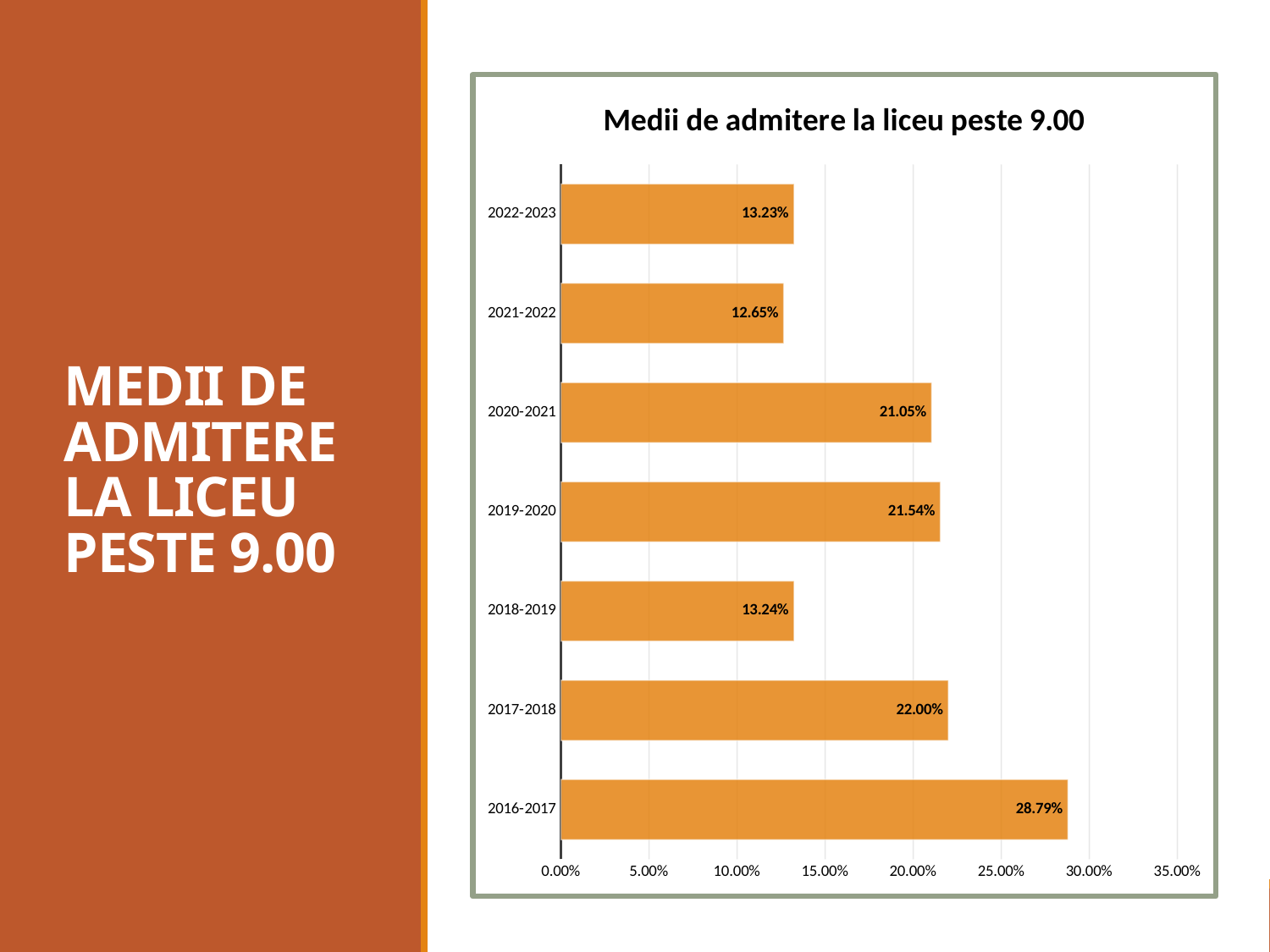
Which is larger, the value for 2017-2018 or the value for 2018-2019? 2017-2018 How many school years are shown in the chart? 7 Which school year has the highest value? 2016-2017 What is the value for 2016-2017? 28.79% What is the value for 2020-2021? 21.05% What is the value for 2022-2023? 13.23% What is the difference between the values for 2019-2020 and 2020-2021? 0.49% What is the difference between the values for 2016-2017 and 2017-2018? 6.79% Is the value for 2019-2020 greater or less than 20.00%? greater What is the title of the chart? Medii de admitere la liceu peste 9.00 What kind of chart is shown on the slide? bar chart Which school year has the lowest value? 2021-2022